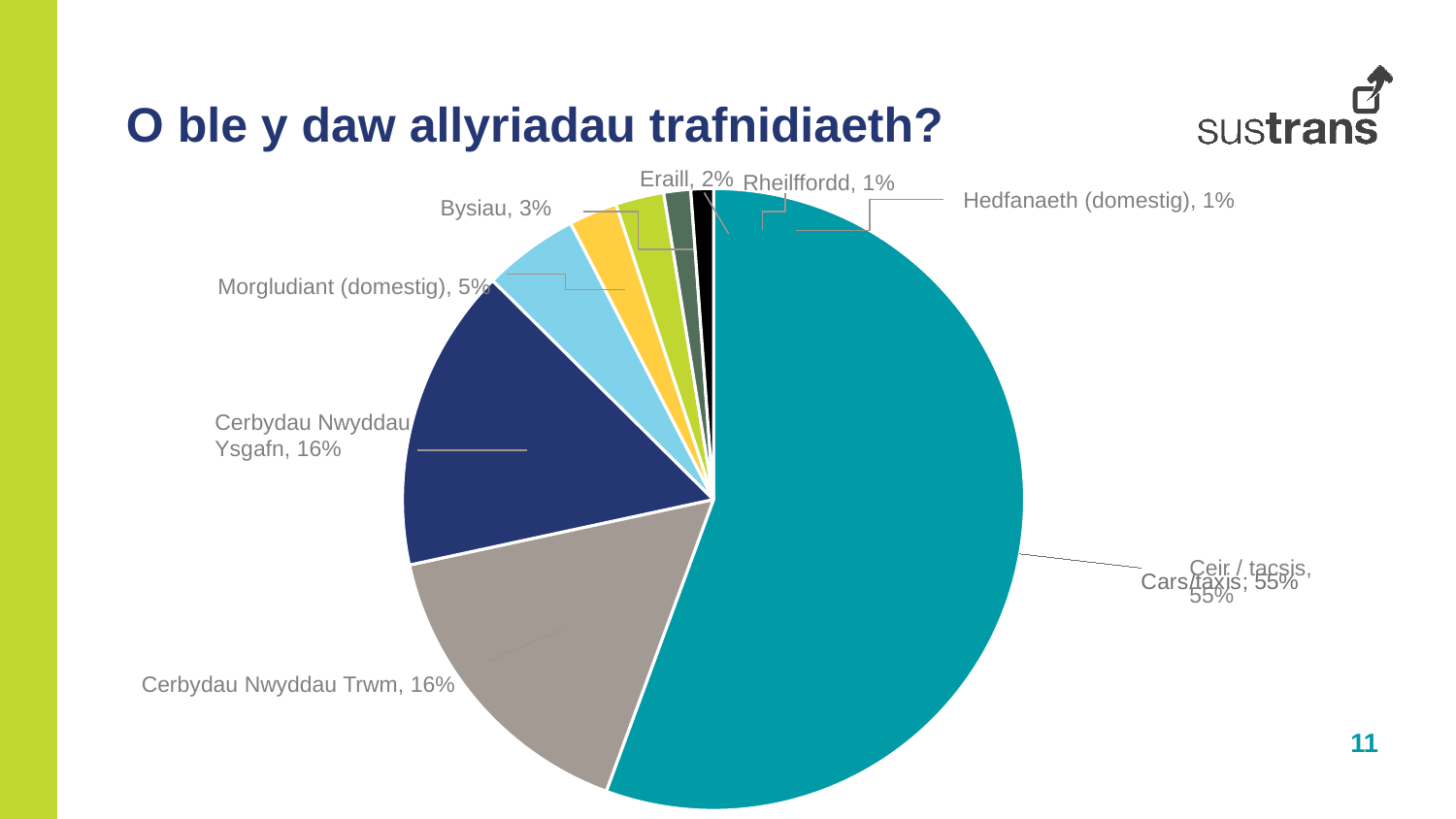
What is the value shown for Rheilffordd? 1% What is the value shown for Cerbydau Nwyddau Trwm? 16% What is the value shown for Morgludiant (domestig)? 5% Which is larger, the share for Morgludiant (domestig) or the share for Bysiau? Morgludiant (domestig) What kind of chart is shown on the slide? pie chart What is the value shown for Bysiau? 3% What share of transport emissions comes from Ceir / tacsis? 55% How many slices does the pie chart have? 8 What is the title of the slide containing the pie chart? O ble y daw allyriadau trafnidiaeth? What is the difference between the share for Ceir / tacsis and the share for Cerbydau Nwyddau Ysgafn? 39% Which category has the largest slice of the pie? Ceir / tacsis What is the value shown for Eraill? 2%